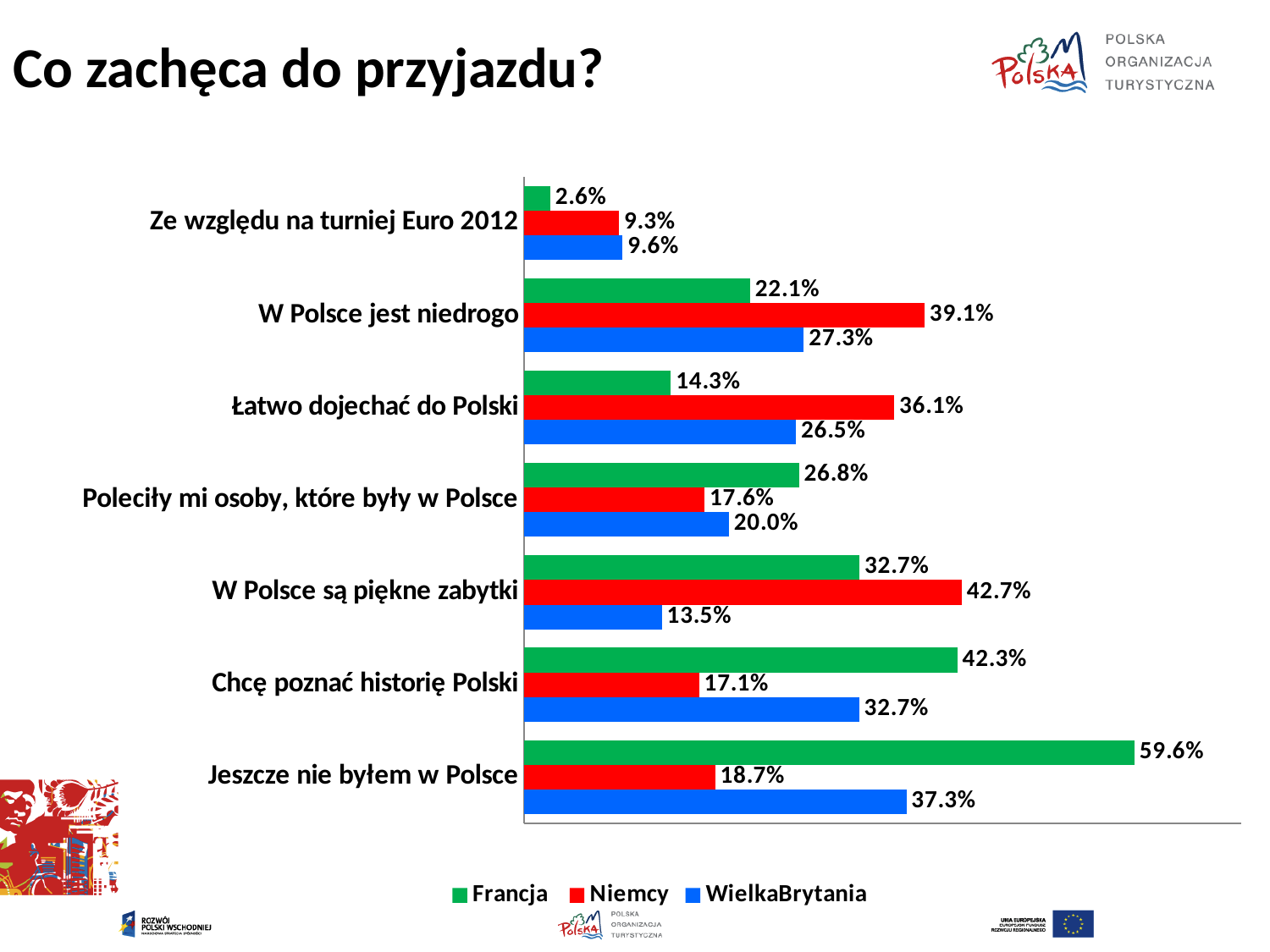
What is the value for WielkaBrytania in the category "Ze względu na turniej Euro 2012"? 9.6% How many series does the legend list? 3 In the category "W Polsce jest niedrogo", which is larger: the value for Niemcy or for WielkaBrytania? Niemcy Which series is shown in green? Francja What is the value for Francja in the category "Jeszcze nie byłem w Polsce"? 59.6% What is the difference between the Francja and Niemcy values in the category "Chcę poznać historię Polski"? 25.2% Which category has the lowest value for Francja? Ze względu na turniej Euro 2012 What is the title of the slide containing the chart? Co zachęca do przyjazdu? What is the value for Niemcy in the category "W Polsce są piękne zabytki"? 42.7% What type of chart is shown on the slide? Bar chart How many categories are shown on the chart? 7 Which category has the highest value for Niemcy? W Polsce są piękne zabytki